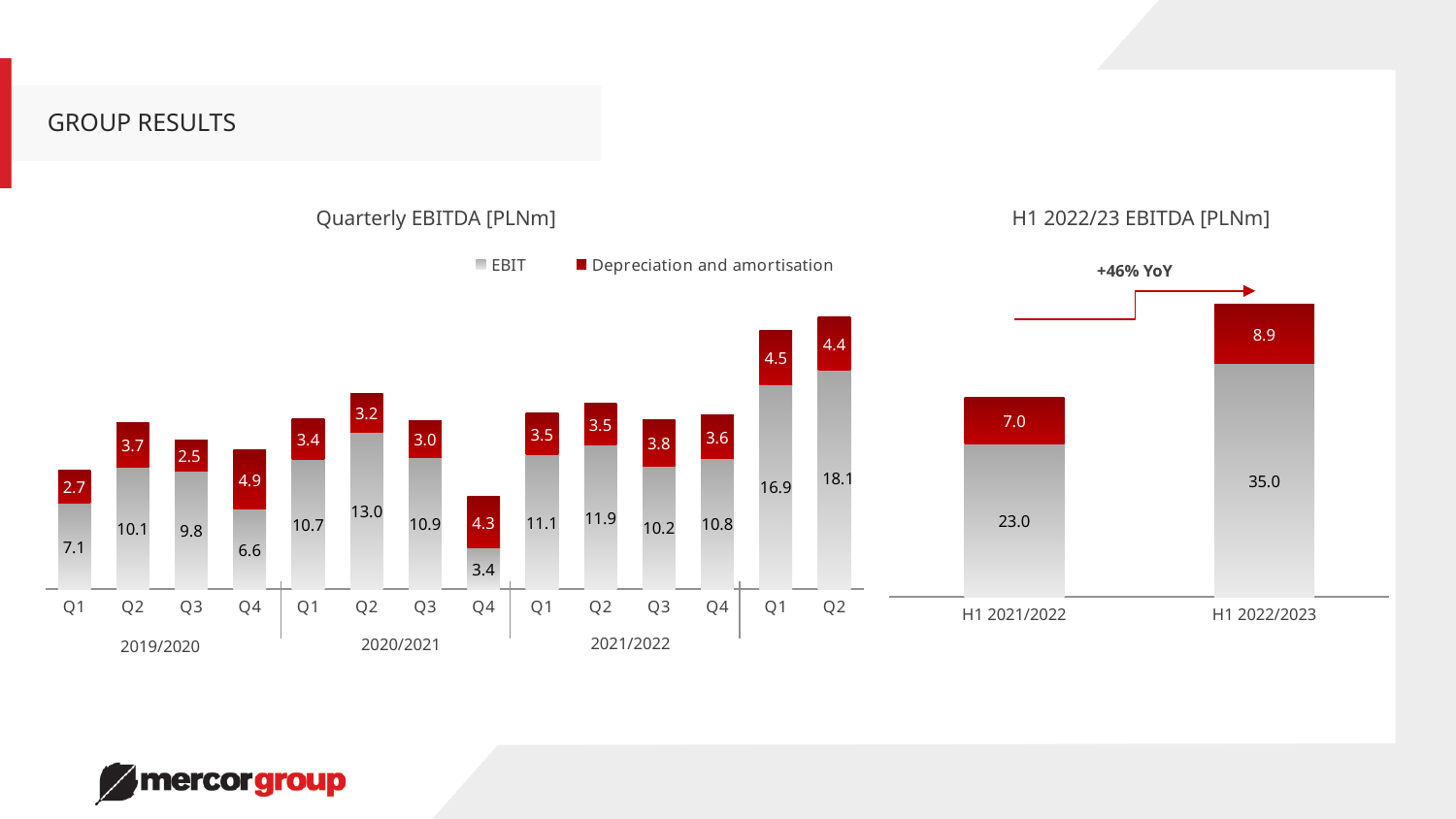
In the Quarterly EBITDA chart, which quarter has the lowest EBIT value? Q4 2020/2021 In the Quarterly EBITDA chart, which quarter has the highest Depreciation and amortisation value? Q4 2019/2020 What year-on-year growth is annotated on the H1 2022/23 EBITDA chart? +46% YoY In the Quarterly EBITDA chart, what is the EBIT value for Q2 2020/2021? 13.0 How many series does the legend of the Quarterly EBITDA chart list? 2 In the H1 2022/23 EBITDA chart, by how much did EBIT increase from H1 2021/2022 to H1 2022/2023? 12.0 In the Quarterly EBITDA chart, which has the higher EBIT: Q1 2021/2022 or Q3 2021/2022? Q1 2021/2022 What kind of chart is the H1 2022/23 EBITDA chart? Stacked bar chart In the Quarterly EBITDA chart, what is the Depreciation and amortisation value for Q4 2019/2020? 4.9 In the H1 2022/23 EBITDA chart, what is the total EBITDA for H1 2022/2023 (EBIT plus Depreciation and amortisation)? 43.9 In the H1 2022/23 EBITDA chart, what is the EBIT value for H1 2022/2023? 35.0 In the H1 2022/23 EBITDA chart, what is the total EBITDA for H1 2021/2022 (EBIT plus Depreciation and amortisation)? 30.0